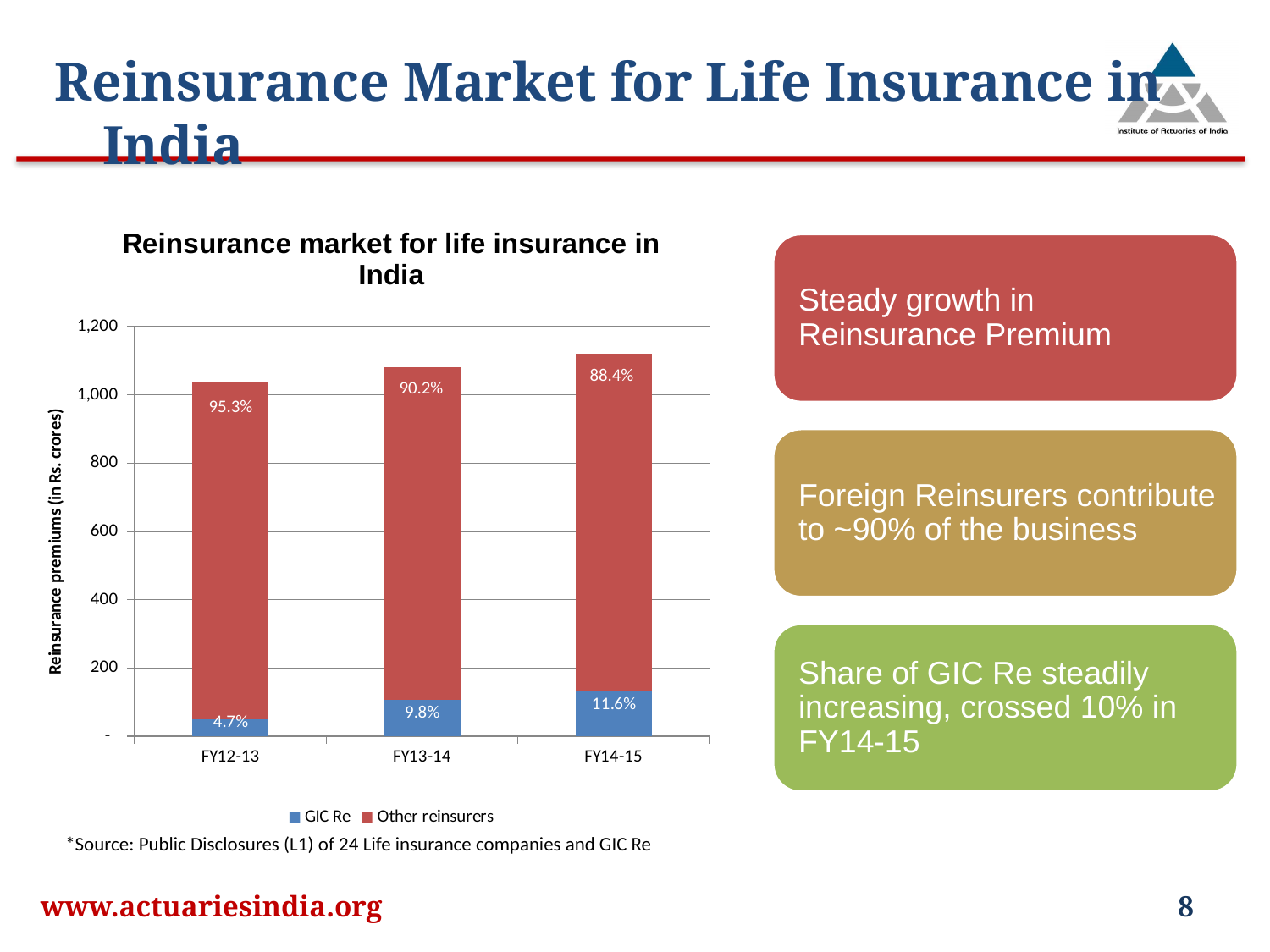
By how many percentage points does the GIC Re label in FY14-15 exceed the GIC Re label in FY12-13? 6.9 percentage points What percentage label is shown for Other reinsurers in FY13-14? 90.2% How many fiscal years are shown on the x axis of the chart? 3 In which fiscal year is the GIC Re percentage label the highest? FY14-15 Is the total reinsurance premium bar for FY14-15 greater or less than 1,000? greater What percentage label is shown for GIC Re in FY12-13? 4.7% Which colour represents GIC Re in the chart? Blue In which fiscal year is the Other reinsurers percentage label the lowest? FY14-15 Do the total reinsurance premiums rise or fall from FY12-13 to FY14-15? Rise How many series does the chart legend list? 2 What percentage label is shown for GIC Re in FY14-15? 11.6% What kind of chart is shown on the slide? Stacked bar chart